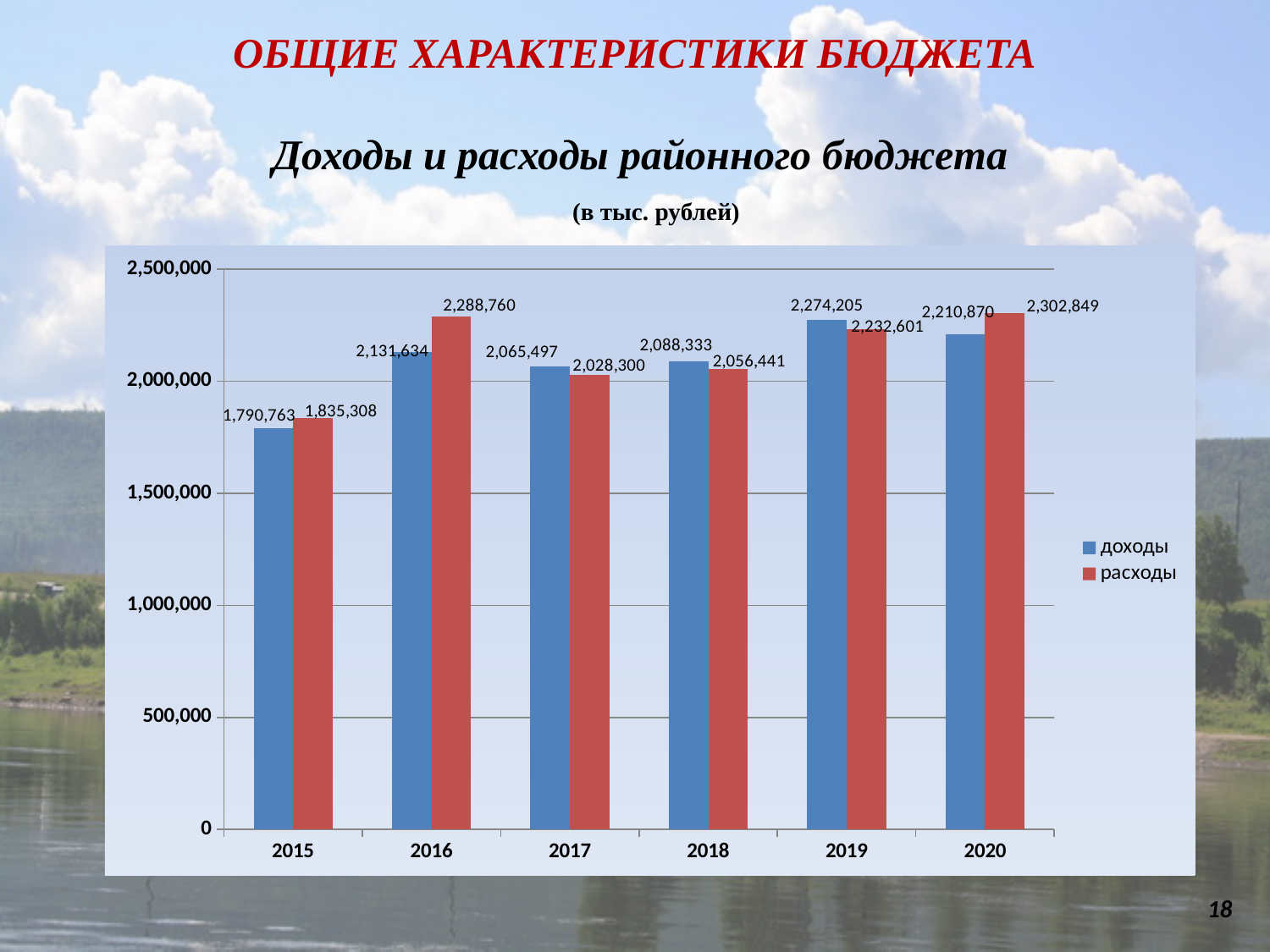
Is the value of доходы for 2015 greater or less than 2,000,000? less In 2018, which is larger: доходы or расходы? доходы In which year is доходы the highest? 2019 In which year is расходы the lowest? 2015 What is the difference between расходы and доходы in 2016? 157,126 What is the value of доходы for 2015? 1,790,763 What kind of chart is shown on the slide? bar chart What is the value of расходы for 2020? 2,302,849 How many series does the legend list? 2 How many years are shown on the x axis? 6 What is the value of расходы for 2017? 2,028,300 What is the difference between доходы and расходы in 2019? 41,604